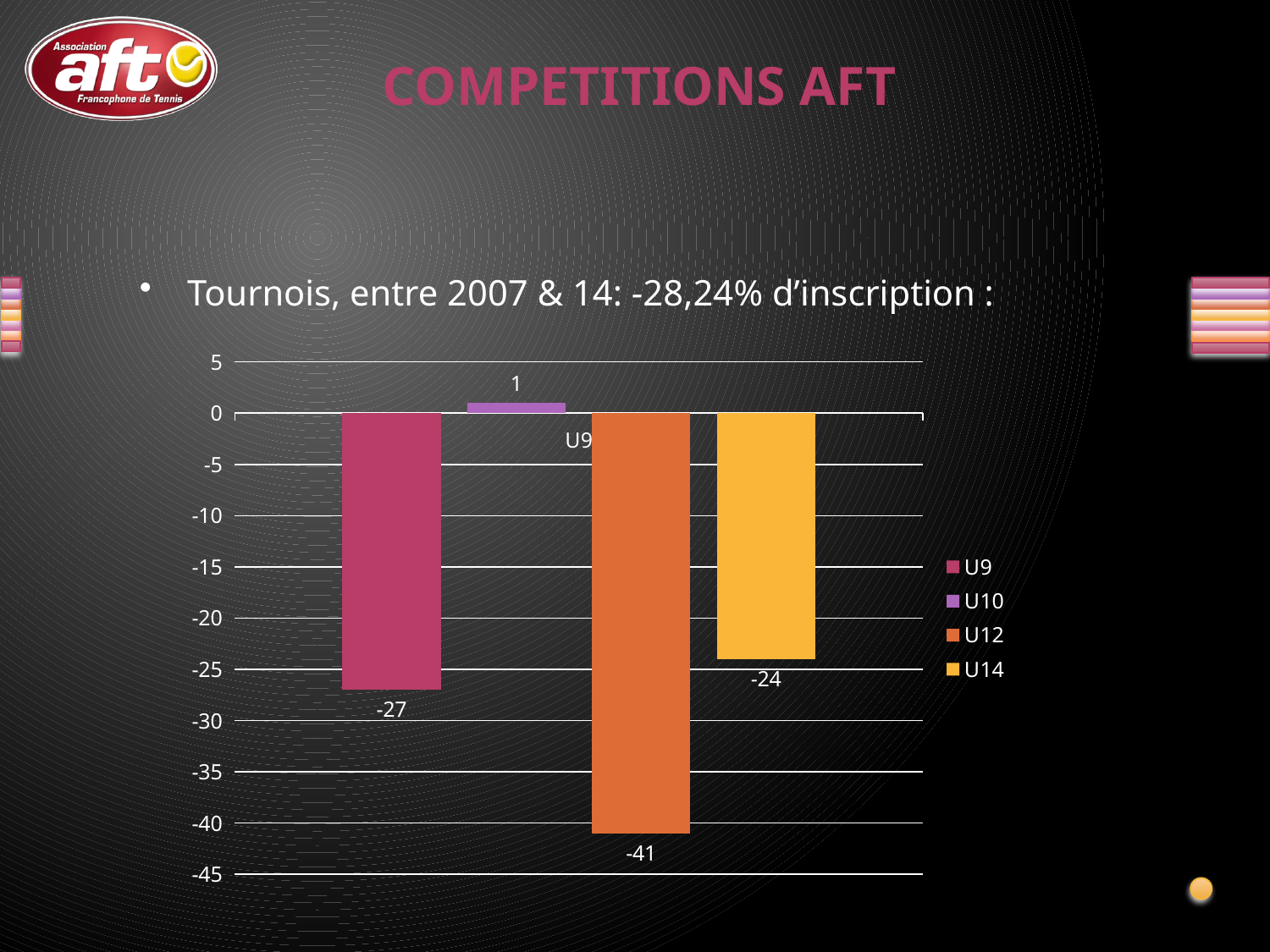
Which is larger, the value for U14 or the value for U12? U14 What colour is the bar for U12? orange What is the value for U9? -27 What is the difference between the values for U12 and U9? 14 What is the value for U14? -24 What kind of chart is shown on the slide? bar chart How many series does the legend list? 4 What is the value for U12? -41 Which series has the highest value? U10 Which series has the lowest value? U12 What is the difference between the values for U9 and U14? 3 What is the value for U10? 1